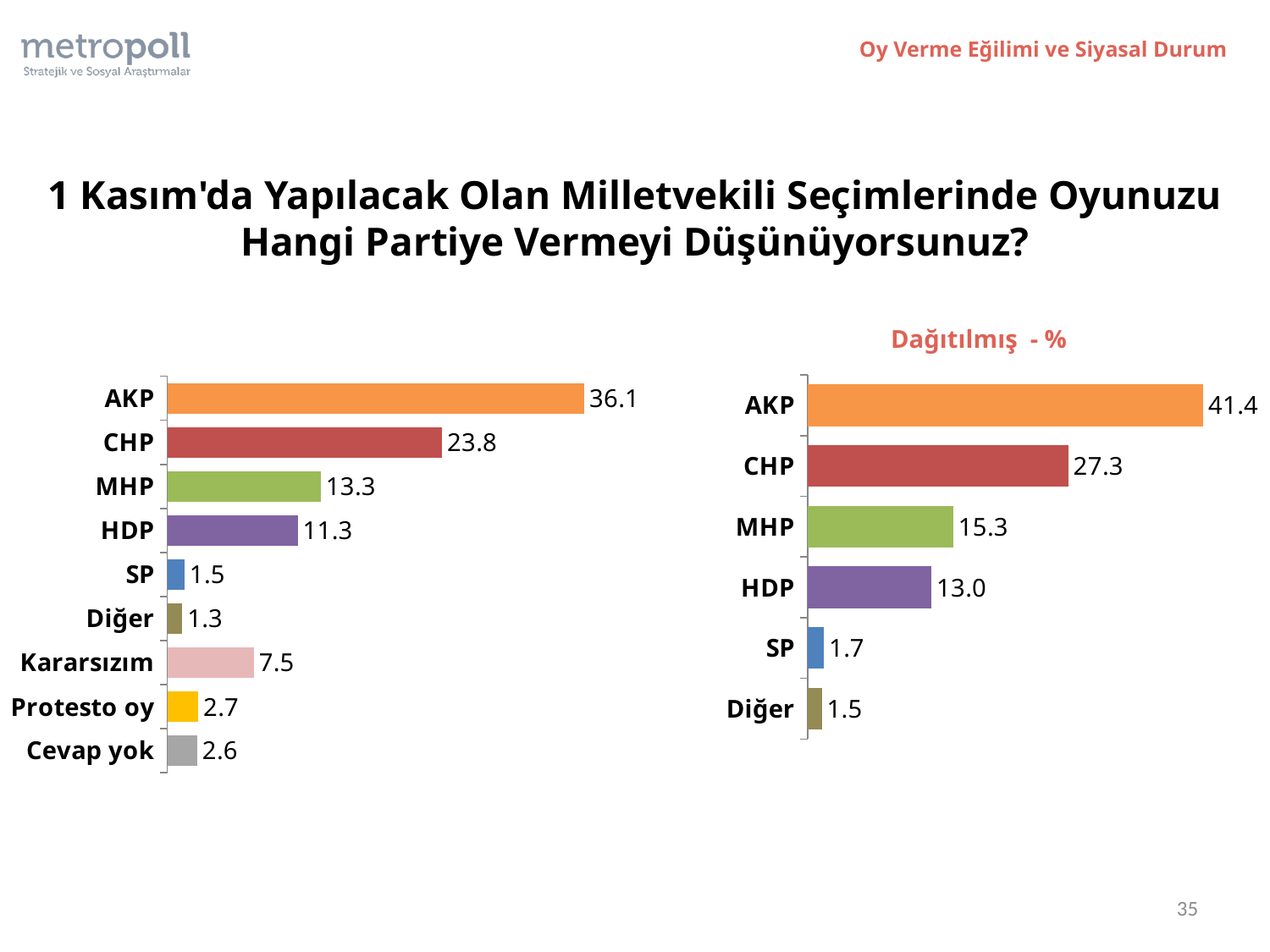
In the right chart titled 'Dağıtılmış - %', which category has the highest value? AKP How many categories does the left chart show? 9 In the left chart, what is the value for Kararsızım? 7.5 In the left chart, which is larger, the value for Protesto oy or the value for Cevap yok? Protesto oy How many categories does the right chart titled 'Dağıtılmış - %' show? 6 In the right chart titled 'Dağıtılmış - %', what is the value for CHP? 27.3 In the left chart, which category has the lowest value? Diğer In the right chart titled 'Dağıtılmış - %', which category has the lowest value? Diğer What kind of chart is the right chart titled 'Dağıtılmış - %'? Bar chart In the right chart titled 'Dağıtılmış - %', what is the difference between the values for MHP and HDP? 2.3 In the left chart, what is the difference between the values for AKP and CHP? 12.3 In the left chart, what is the value for AKP? 36.1